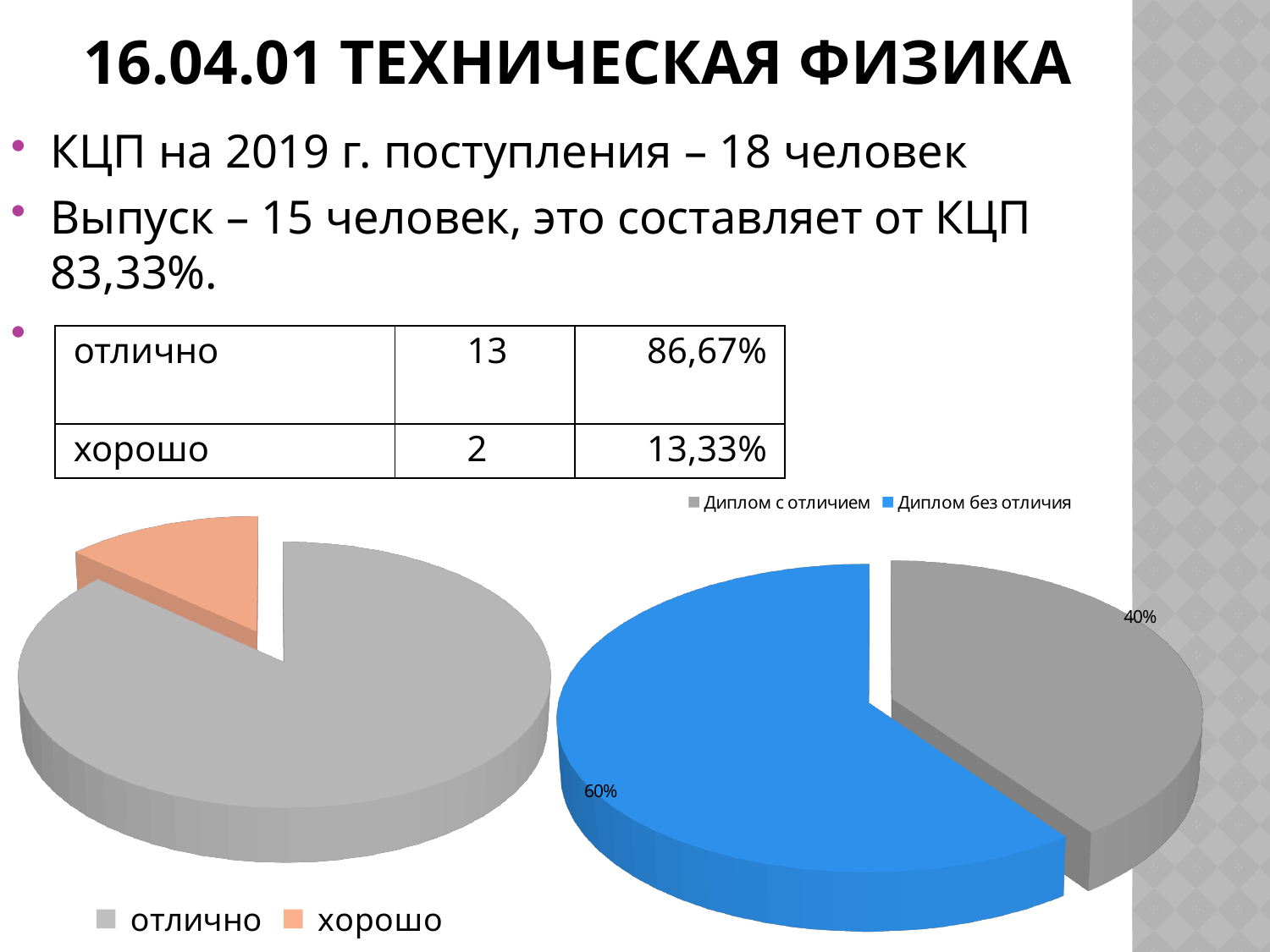
In the right pie chart, what is the difference in percentage points between 'Диплом без отличия' and 'Диплом с отличием'? 20 In the left pie chart, which category has the largest slice? отлично How many slices does the left pie chart have? 2 In the right pie chart, which category has the largest share? Диплом без отличия In the right pie chart, what percentage is shown for 'Диплом с отличием'? 40% What kind of chart is the left chart with the legend 'отлично' and 'хорошо'? pie chart In the right pie chart, what colour is the slice for 'Диплом без отличия'? blue In the left pie chart, which slice is larger: 'отлично' or 'хорошо'? отлично What kind of chart is the right chart with the legend 'Диплом с отличием' and 'Диплом без отличия'? pie chart In the left pie chart, which category has the smallest slice? хорошо In the right pie chart, what percentage is shown for 'Диплом без отличия'? 60% How many entries does the legend of the right pie chart list? 2